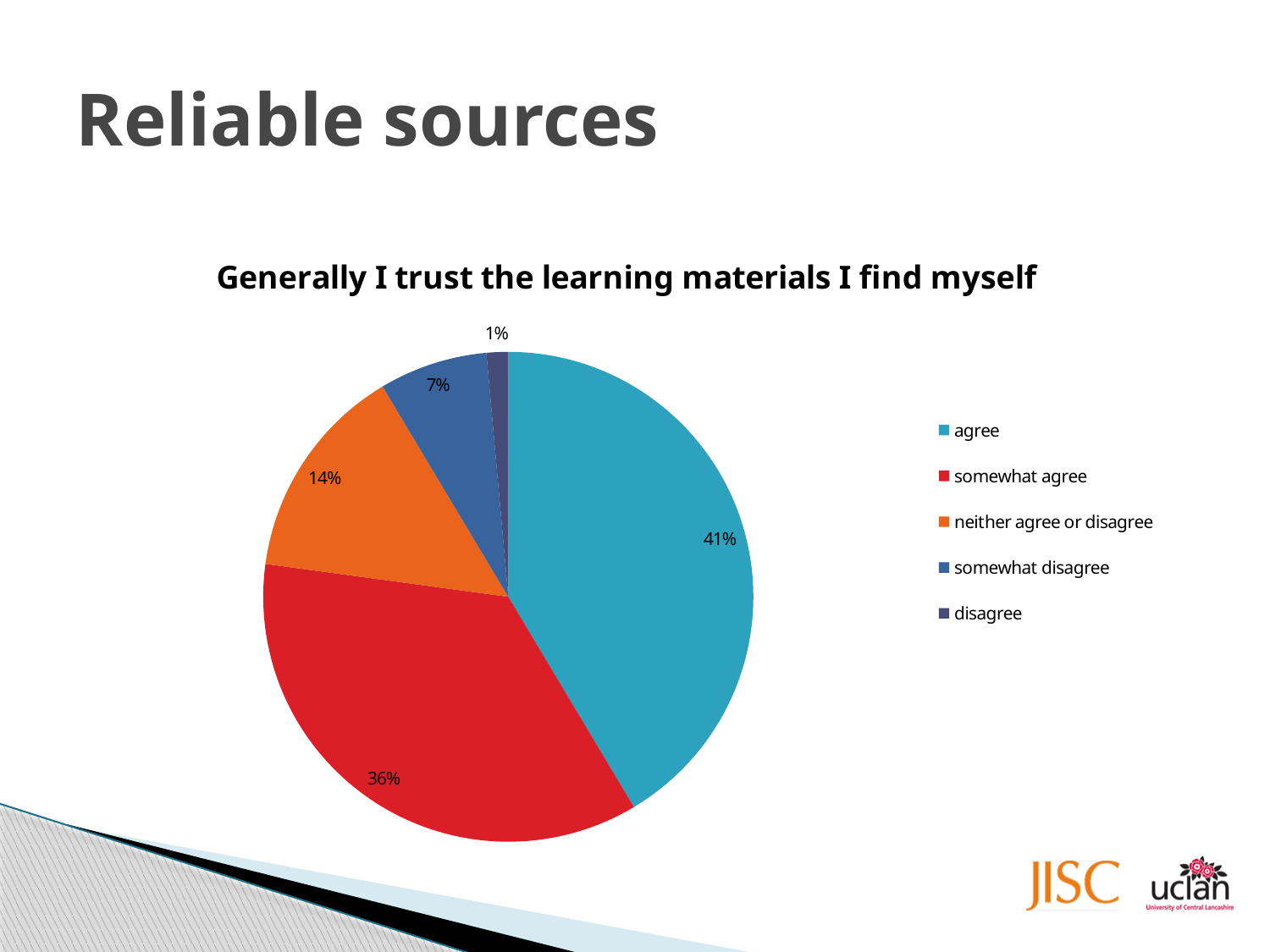
Which is larger, the share for "neither agree or disagree" or the share for "somewhat disagree"? neither agree or disagree What percentage of respondents chose "disagree"? 1% What is the title of the chart? Generally I trust the learning materials I find myself What percentage of respondents chose "somewhat agree"? 36% What percentage of respondents chose "neither agree or disagree"? 14% What is the difference in percentage points between "agree" and "somewhat agree"? 5 How many categories does the legend list? 5 Which response category has the smallest share of the pie? disagree What percentage of respondents chose "agree"? 41% Which response category has the largest share of the pie? agree What percentage of respondents chose "somewhat disagree"? 7% What type of chart is shown on the slide? pie chart